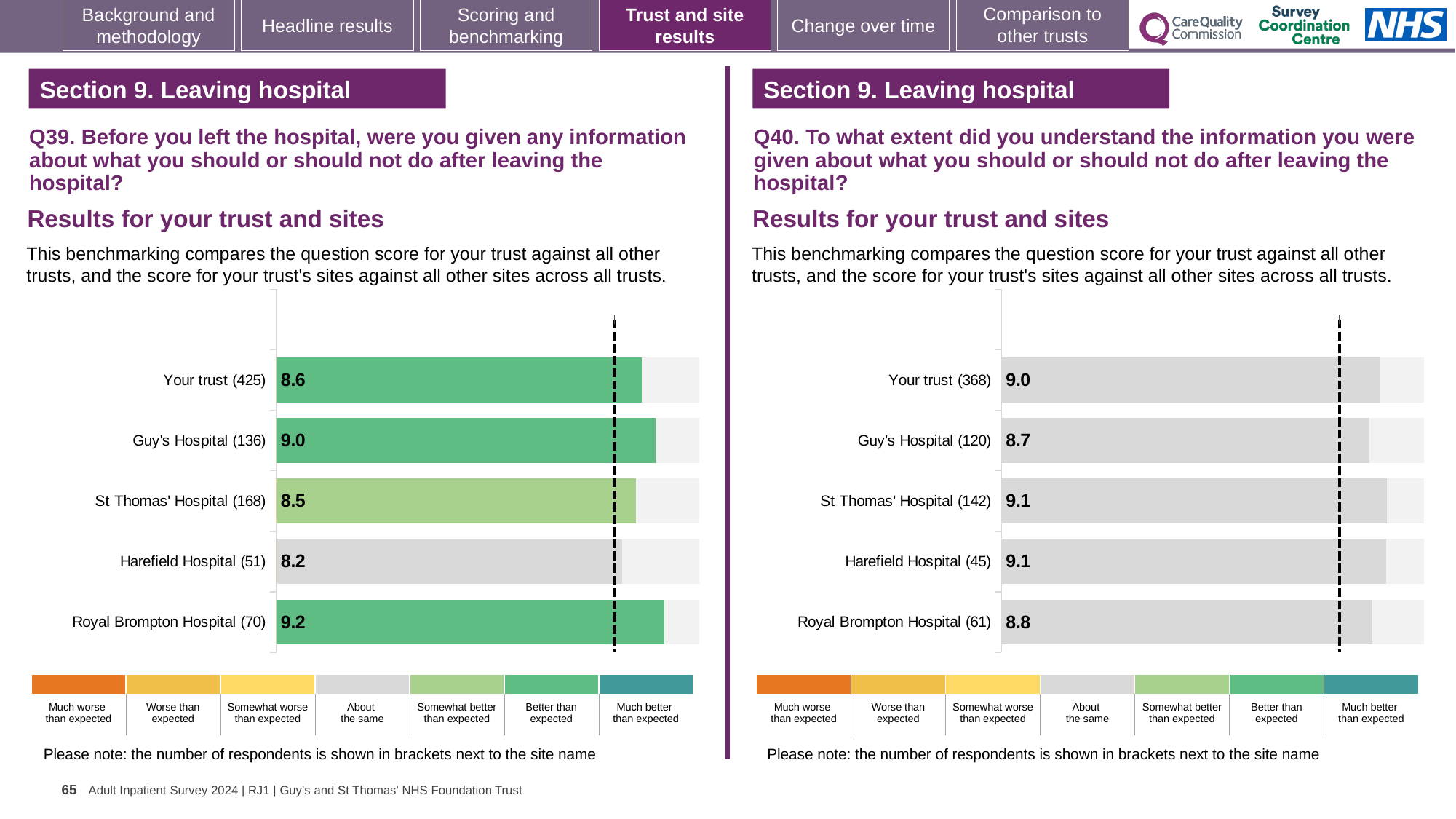
In the Q40 chart on the right, which has the higher score, St Thomas' Hospital or Royal Brompton Hospital? St Thomas' Hospital What type of chart is used for the Q39 results on the left? Bar chart In the Q39 chart on the left, what is the difference between the scores for Guy's Hospital and St Thomas' Hospital? 0.5 In the Q39 chart on the left, how many bars are plotted? 5 In the Q39 chart on the left, which site or trust has the highest score? Royal Brompton Hospital In the Q40 chart on the right, what is the score for Your trust? 9.0 In the Q40 chart on the right, what is the score for Guy's Hospital? 8.7 In the Q40 chart on the right, which site or trust has the lowest score? Guy's Hospital In the Q39 chart on the left, what is the score for Harefield Hospital? 8.2 In the Q39 chart on the left, what is the score for Royal Brompton Hospital? 9.2 In the Q40 chart on the right, what is the difference between the scores for Harefield Hospital and Guy's Hospital? 0.4 In the Q39 chart on the left, which site or trust has the lowest score? Harefield Hospital